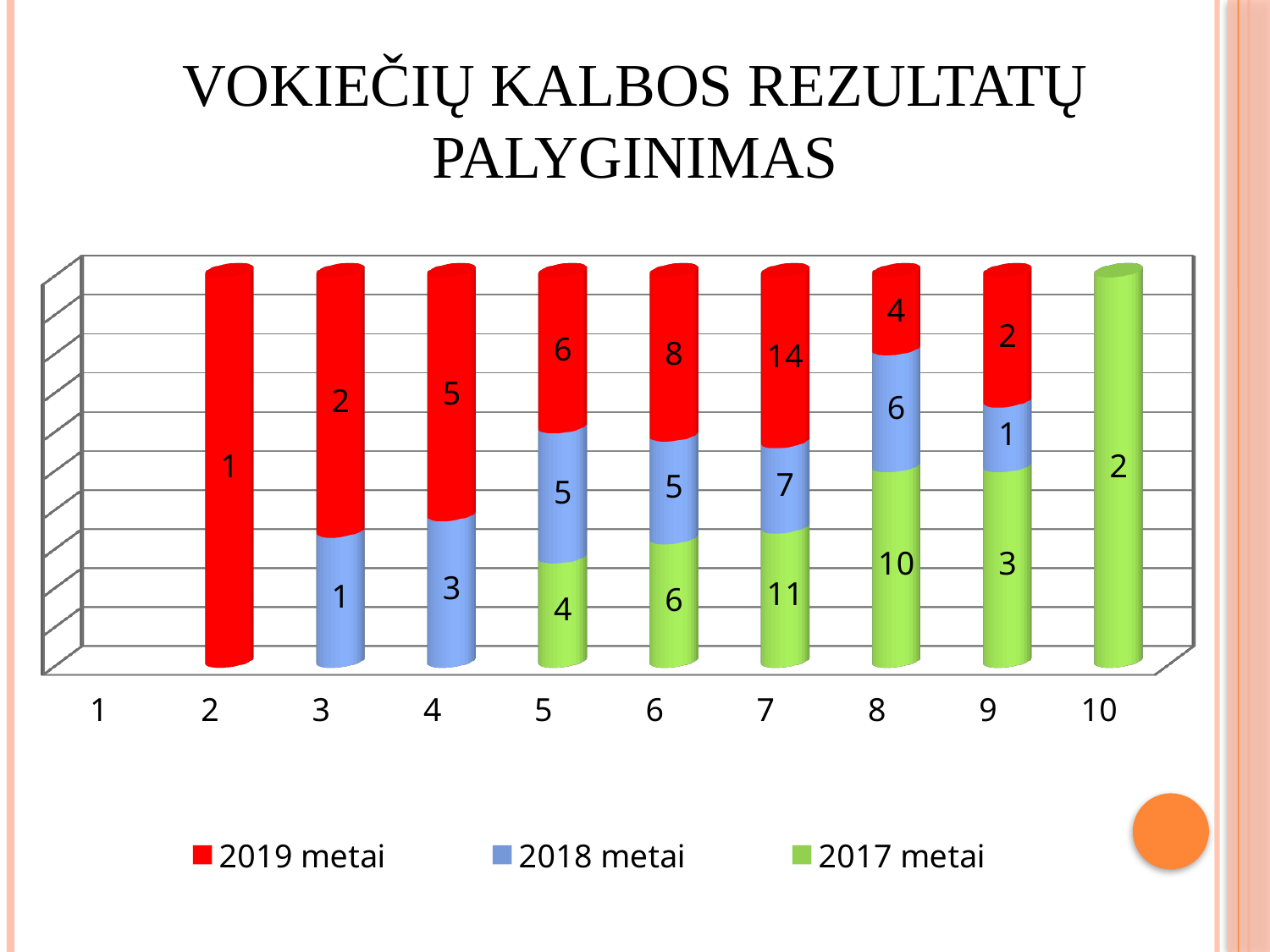
What is the value for 2017 metai at category 8? 10 What is the difference between the 2019 metai value and the 2018 metai value at category 7? 7 What is the value for 2018 metai at category 4? 3 Which is larger at category 8: the 2019 metai value or the 2017 metai value? 2017 metai How many categories are shown on the x axis? 10 What kind of chart is shown on the slide? Stacked bar chart Which category has the highest value for the 2019 metai series? 7 How many series does the legend list? 3 What is the total of the three labelled values in the bar for category 5? 15 What is the value for 2017 metai at category 10? 2 Which category has the lowest value for the 2019 metai series? 2 What is the value for 2019 metai at category 7? 14